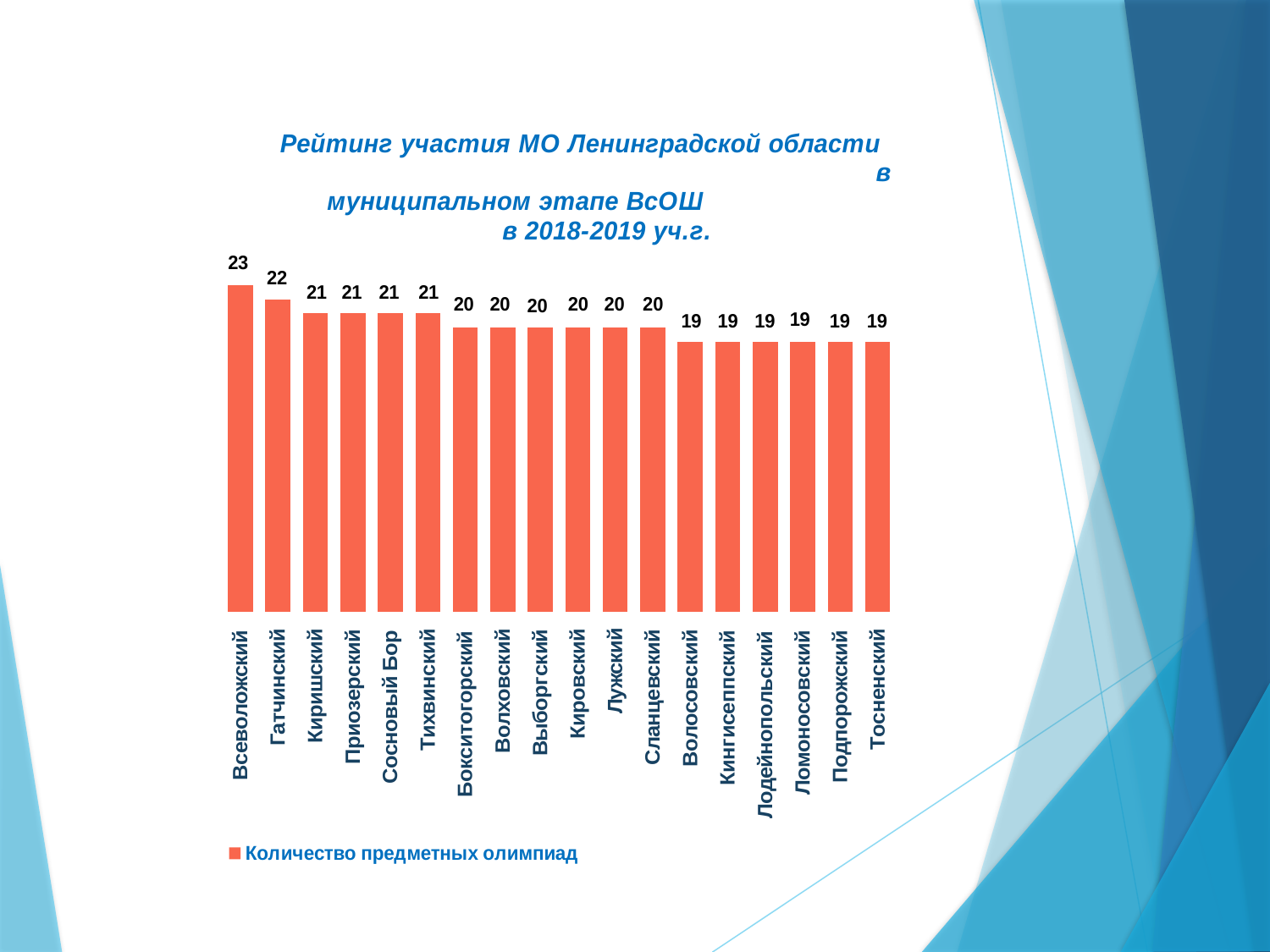
What is the value for Всеволожский? 23 Which category has the highest value? Всеволожский What is the legend entry for the series? Количество предметных олимпиад What is the difference between the values for Всеволожский and Тосненский? 4 How many categories are shown on the x axis? 18 How many series does the legend list? 1 What is the value for Гатчинский? 22 What type of chart is shown on the slide? Bar chart What is the value for Лужский? 20 What is the value for Тосненский? 19 Which is larger, the value for Гатчинский or the value for Кировский? Гатчинский What is the value for Сосновый Бор? 21